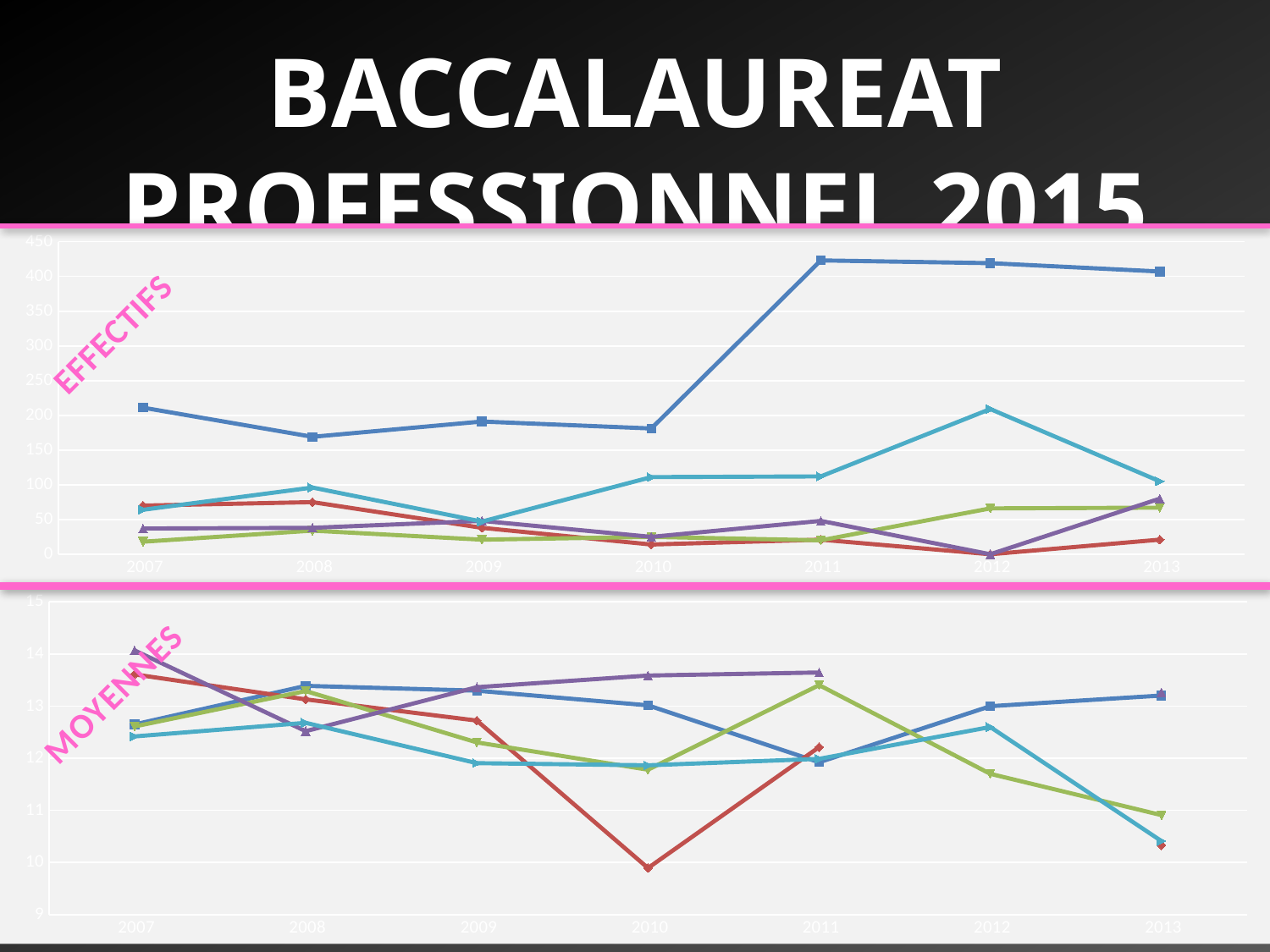
In the top chart (EFFECTIFS), does the blue line rise or fall between 2010 and 2011? rise How many years are shown on the x axis of the top chart (EFFECTIFS)? 7 In the top chart (EFFECTIFS), in which year does the blue line reach its highest value? 2011 What are the labels written beside the top and bottom charts? EFFECTIFS and MOYENNES In the top chart (EFFECTIFS), is the value of the blue line in 2011 greater or less than 400? greater In the top chart (EFFECTIFS), which is larger in 2013, the blue line or the cyan line? the blue line In the top chart (EFFECTIFS), is the value of the cyan line in 2012 greater or less than 150? greater In the bottom chart (MOYENNES), in which year does the red line reach its lowest value? 2010 What kind of chart is the bottom chart labelled MOYENNES? line chart In the top chart (EFFECTIFS), is the value of the blue line in 2010 greater or less than 200? less What kind of chart is the top chart labelled EFFECTIFS? line chart